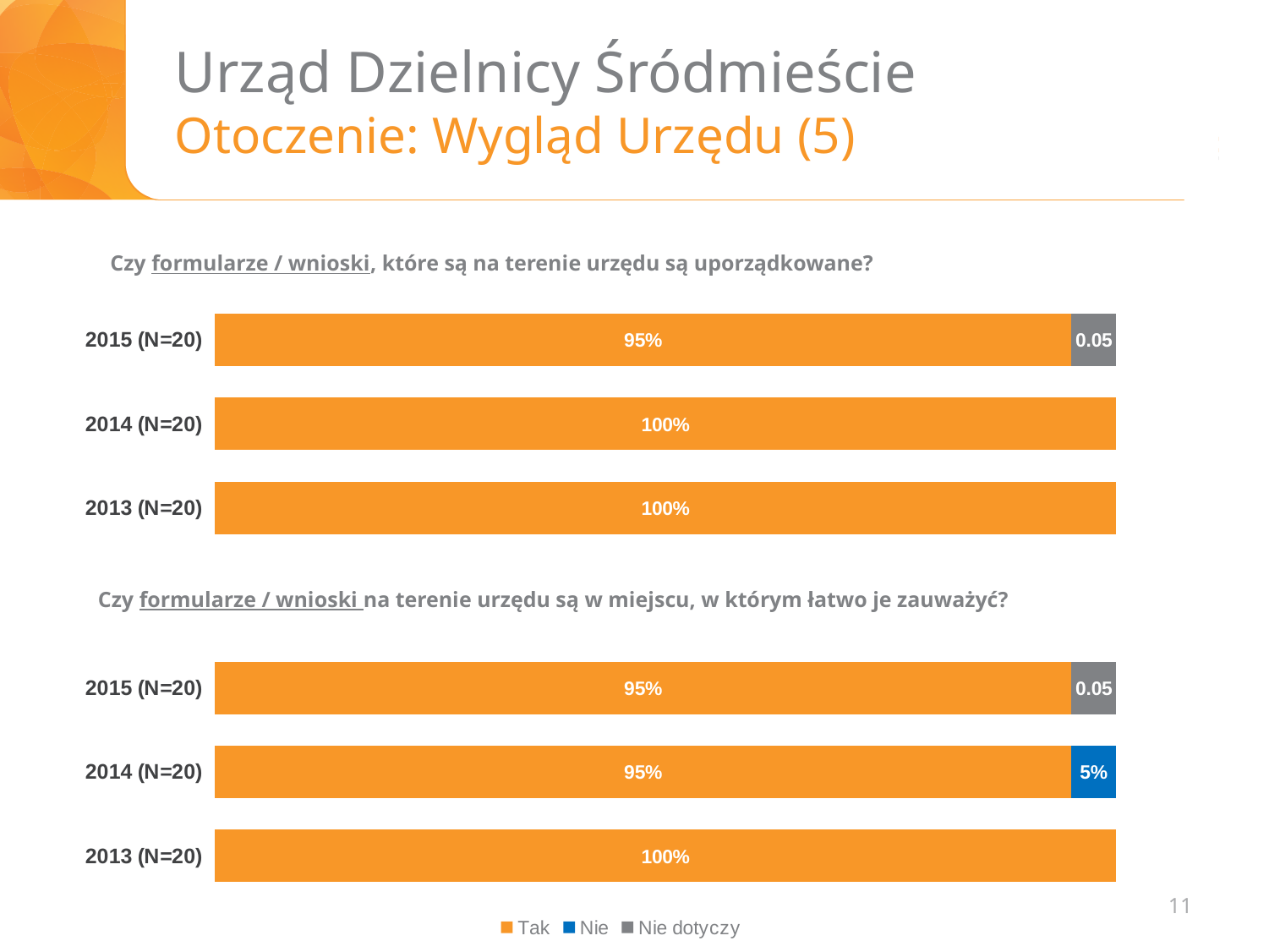
What type of chart is the bottom chart ("Czy formularze / wnioski na terenie urzędu są w miejscu, w którym łatwo je zauważyć?")? Stacked horizontal bar chart In the bottom chart ("Czy formularze / wnioski na terenie urzędu są w miejscu, w którym łatwo je zauważyć?"), what is the value for Tak in 2013 (N=20)? 100% In the bottom chart ("Czy formularze / wnioski na terenie urzędu są w miejscu, w którym łatwo je zauważyć?"), which year has the lowest Tak value? 2015 (N=20) and 2014 (N=20), both 95% How many year categories does the top chart ("Czy formularze / wnioski, które są na terenie urzędu są uporządkowane?") show? 3 What are the three legend entries shown at the bottom of the slide? Tak, Nie, Nie dotyczy In the top chart ("Czy formularze / wnioski, które są na terenie urzędu są uporządkowane?"), what is the difference between the Tak value in 2014 (N=20) and in 2015 (N=20)? 5 percentage points How many series does the legend at the bottom of the slide list? 3 In the bottom chart ("Czy formularze / wnioski na terenie urzędu są w miejscu, w którym łatwo je zauważyć?"), what is the value for Nie in 2014 (N=20)? 5% In the top chart ("Czy formularze / wnioski, które są na terenie urzędu są uporządkowane?"), what is the value for Tak in 2014 (N=20)? 100% In the top chart ("Czy formularze / wnioski, które są na terenie urzędu są uporządkowane?"), what value is printed on the grey Nie dotyczy segment for 2015 (N=20)? 0.05 In the top chart ("Czy formularze / wnioski, które są na terenie urzędu są uporządkowane?"), what is the value for Tak in 2015 (N=20)? 95% In the bottom chart ("Czy formularze / wnioski na terenie urzędu są w miejscu, w którym łatwo je zauważyć?"), is the Tak value for 2013 (N=20) larger or smaller than for 2014 (N=20)? larger